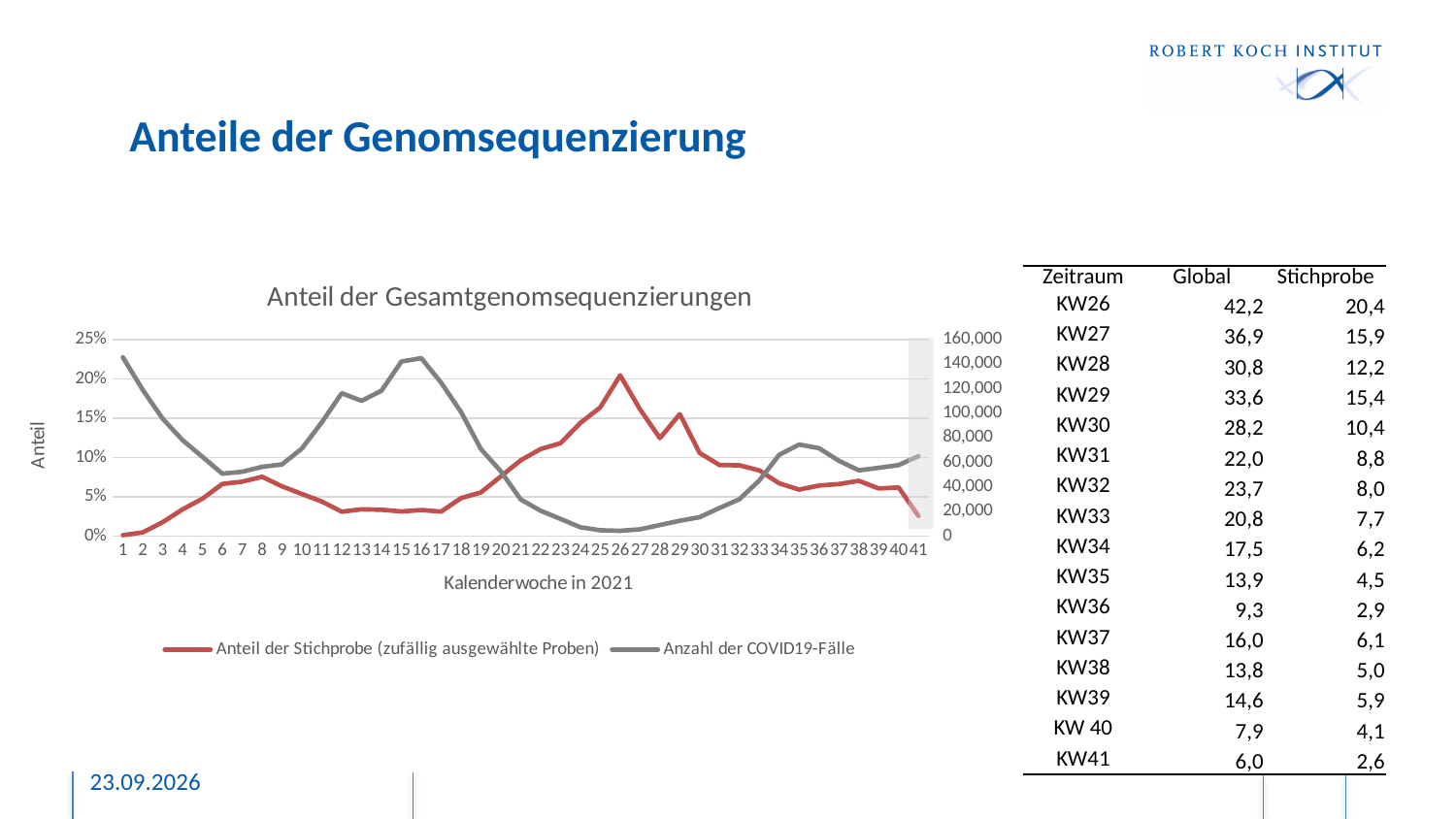
Is the value of Anzahl der COVID19-Fälle in calendar week 26 greater or less than 20,000? less What kind of chart is shown on the slide? line chart How many series does the chart legend list? 2 Which series is drawn in red in the chart? Anteil der Stichprobe (zufällig ausgewählte Proben) In which calendar week does Anteil der Stichprobe reach its highest value? 26 Which is larger for Anteil der Stichprobe: the value in calendar week 8 or the value in calendar week 26? calendar week 26 Is the value of Anzahl der COVID19-Fälle in calendar week 16 greater or less than 120,000? greater What is the title of the chart? Anteil der Gesamtgenomsequenzierungen How many calendar weeks are plotted along the x axis of the chart? 41 Is the value of Anteil der Stichprobe in calendar week 1 greater or less than 5%? less Does the Anzahl der COVID19-Fälle line rise or fall between calendar week 16 and calendar week 26? fall